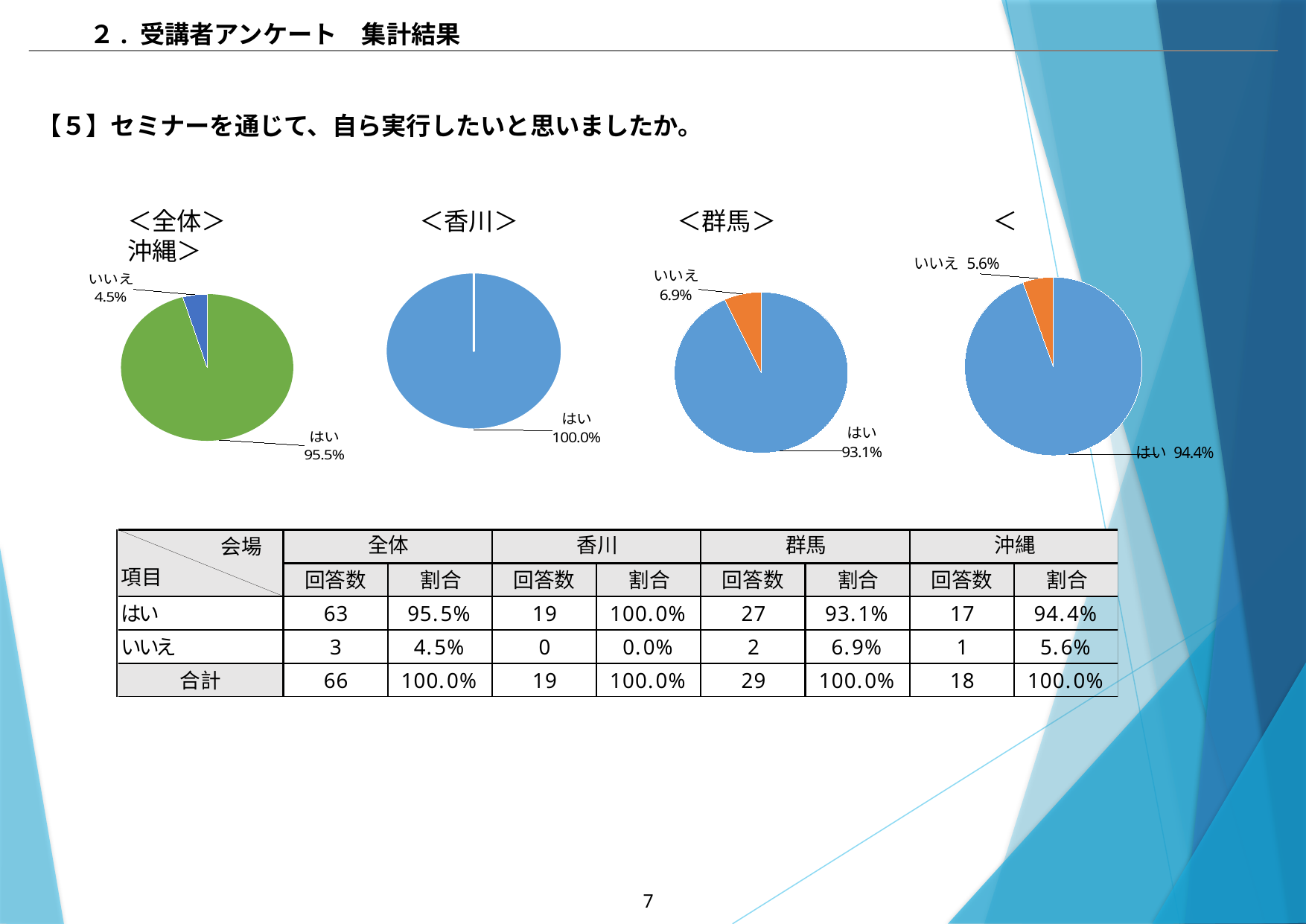
Which is larger: the いいえ share in the ＜群馬＞ pie chart or the いいえ share in the ＜沖縄＞ pie chart? ＜群馬＞ In the ＜沖縄＞ pie chart, what share is labelled for はい? 94.4% In the ＜香川＞ pie chart, what share is labelled for はい? 100.0% In the ＜全体＞ pie chart, what share is labelled for はい? 95.5% In the ＜全体＞ pie chart, which slice is the largest? はい In the ＜群馬＞ pie chart, what share is labelled for いいえ? 6.9% In the ＜群馬＞ pie chart, what share is labelled for はい? 93.1% In the ＜沖縄＞ pie chart, what share is labelled for いいえ? 5.6% In the ＜全体＞ pie chart, what is the difference between the はい share and the いいえ share? 91.0% What kind of chart is the ＜香川＞ chart? Pie chart In the ＜全体＞ pie chart, what share is labelled for いいえ? 4.5% In the ＜群馬＞ pie chart, which slice is the smallest? いいえ